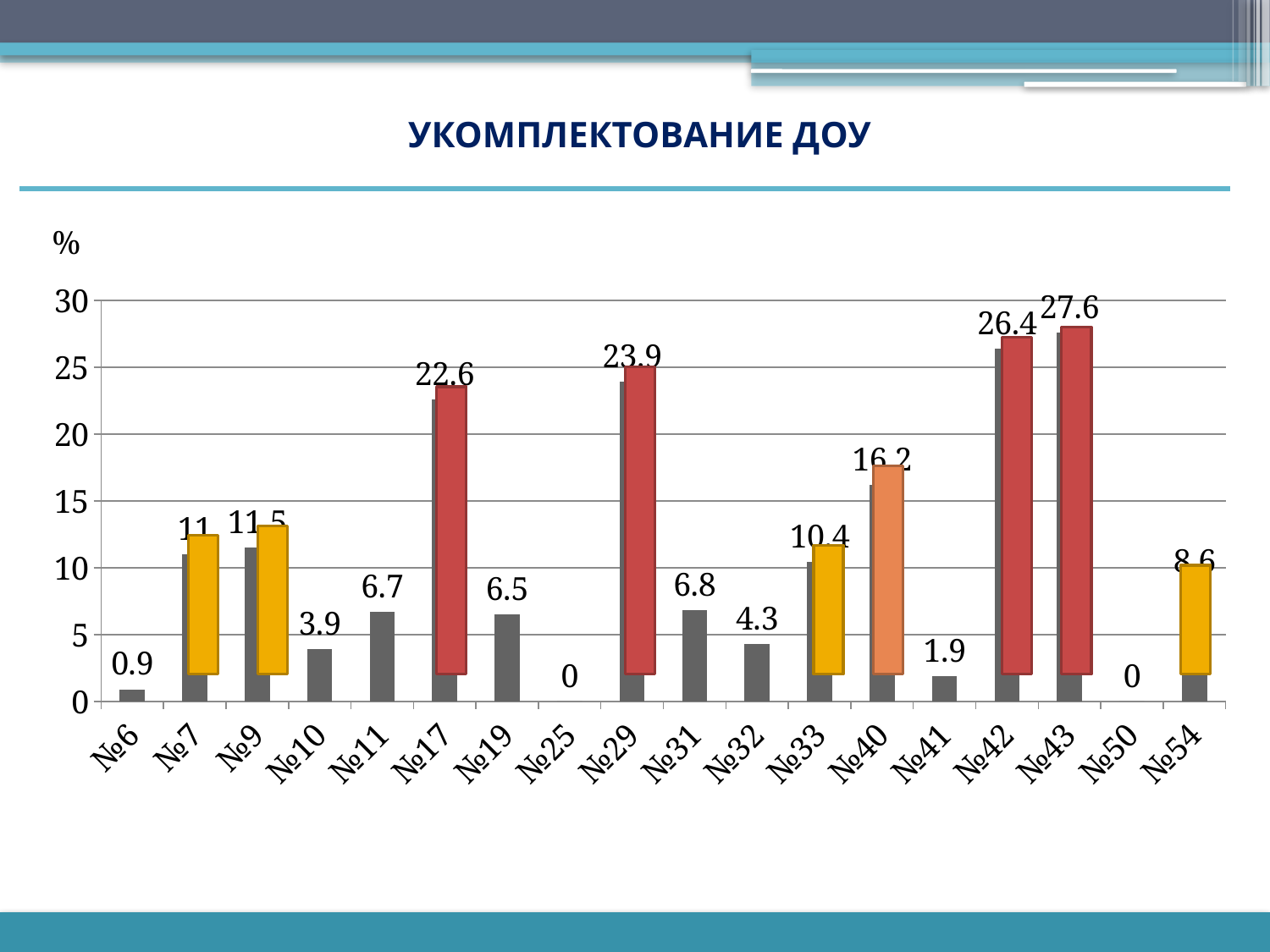
Which is larger, the value for №29 or the value for №17? №29 Which categories have a value of 0? №25 and №50 What kind of chart is shown on the slide? bar chart How many categories are shown on the x axis? 18 Which category has the highest value? №43 What is the value for №40? 16.2 What is the value for №17? 22.6 What is the title of the chart? УКОМПЛЕКТОВАНИЕ ДОУ What is the value for №6? 0.9 What unit is shown on the y axis label? % What is the difference between the values for №43 and №42? 1.2 Is the value for №33 greater or less than 10? greater